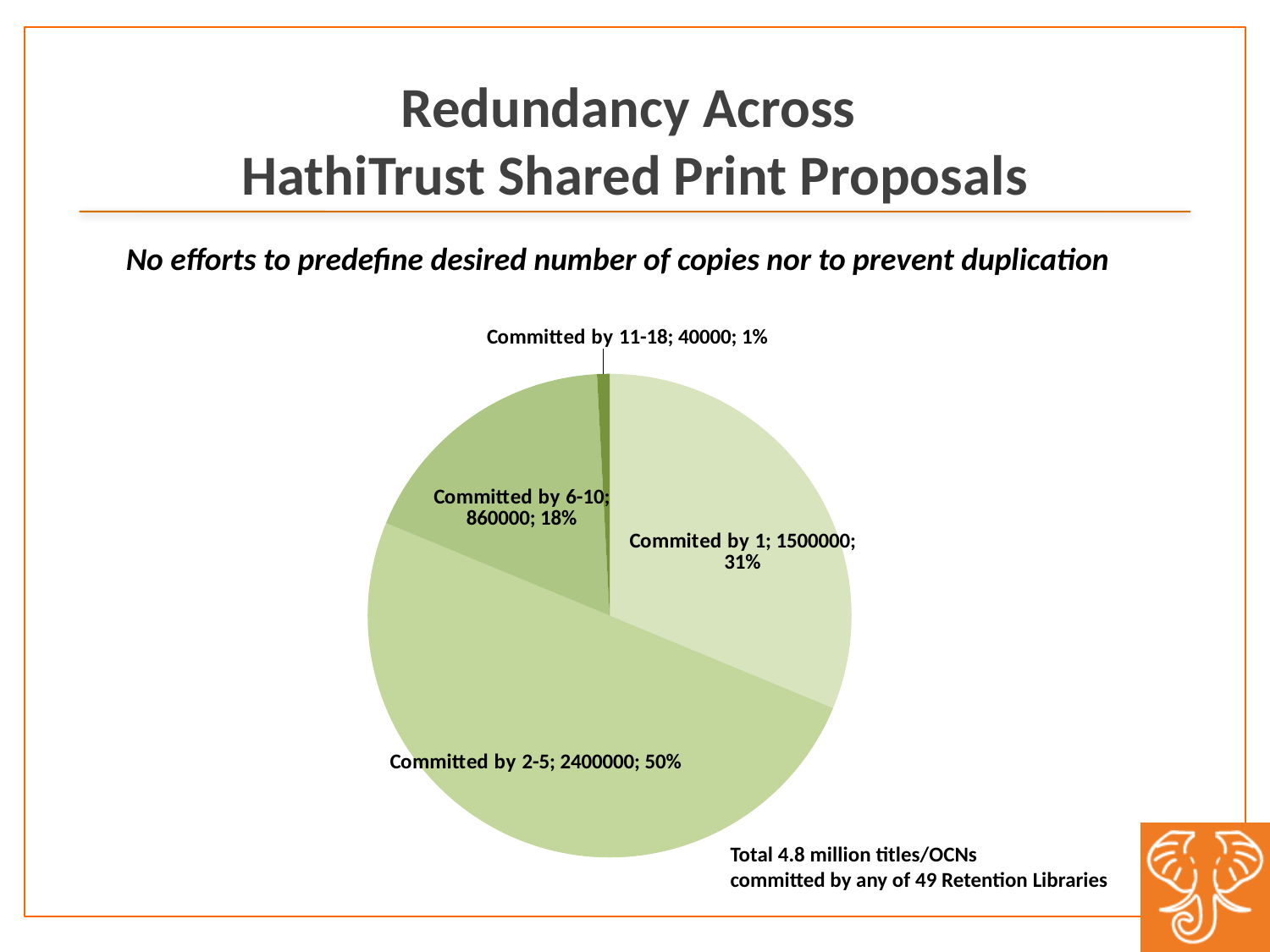
What is the value for the slice labelled 'Committed by 6-10'? 860000 What is the value for the slice labelled 'Committed by 11-18'? 40000 What is the difference between the values for 'Committed by 2-5' and 'Commited by 1'? 900000 Which slice is the largest? Committed by 2-5 What kind of chart is shown on the slide? pie chart According to the note on the slide, how many Retention Libraries committed the titles? 49 How many slices does the pie chart have? 4 What share of the pie is the 'Commited by 1' slice? 31% Which slice is the smallest? Committed by 11-18 What is the value for the slice labelled 'Committed by 2-5'? 2400000 Which is larger, the value for 'Committed by 6-10' or the value for 'Committed by 11-18'? Committed by 6-10 What share of the pie is the 'Committed by 6-10' slice? 18%